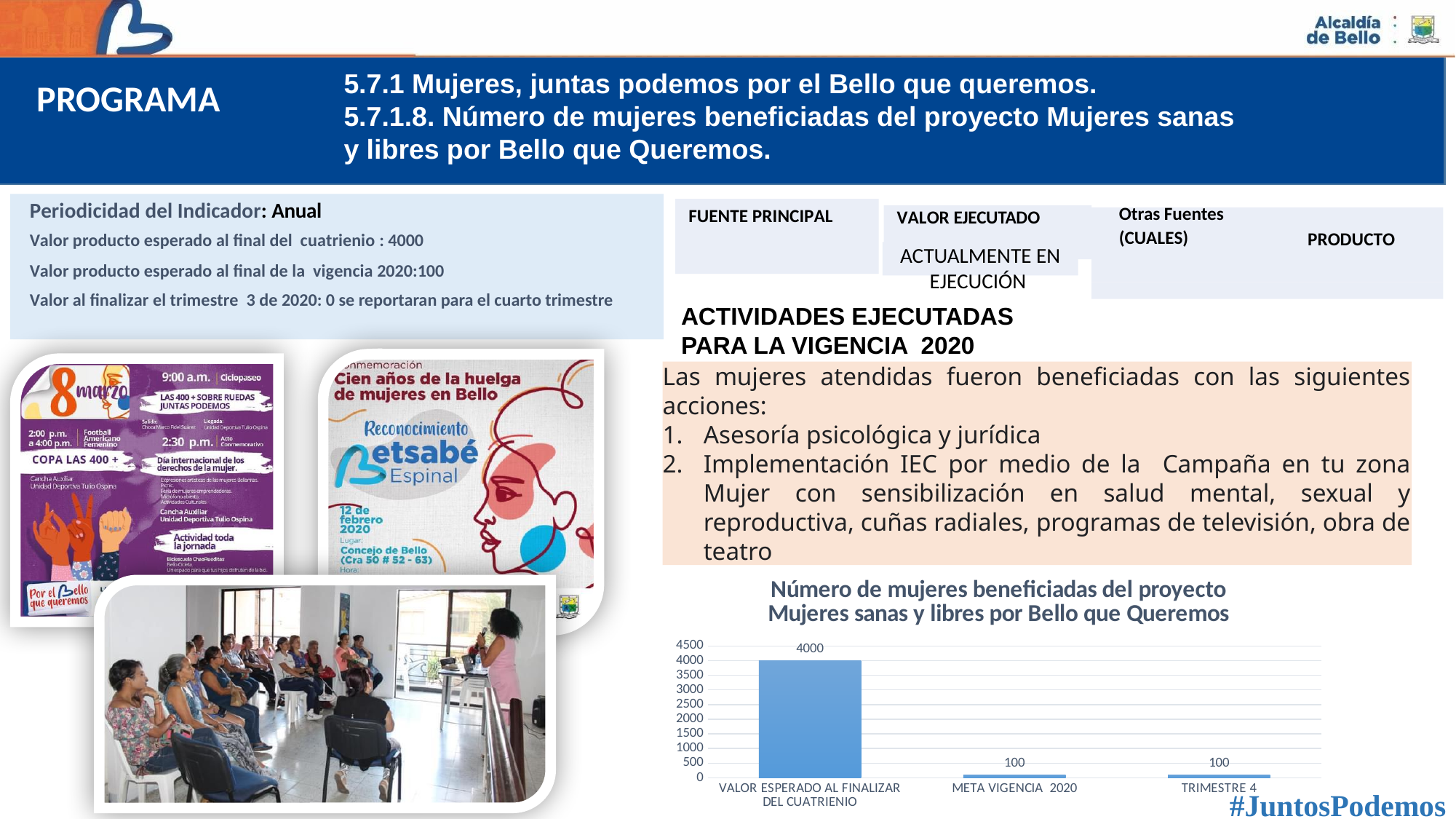
What is the title of the chart? Número de mujeres beneficiadas del proyecto Mujeres sanas y libres por Bello que Queremos Is the value for VALOR ESPERADO AL FINALIZAR DEL CUATRIENIO greater or less than 3500? greater How many categories are shown in the chart? 3 What is the value for TRIMESTRE 4 in the chart? 100 What is the difference between the value for VALOR ESPERADO AL FINALIZAR DEL CUATRIENIO and the value for META VIGENCIA 2020? 3900 What is the value for META VIGENCIA 2020 in the chart? 100 Which category has the highest value in the chart? VALOR ESPERADO AL FINALIZAR DEL CUATRIENIO Which is larger, the value for VALOR ESPERADO AL FINALIZAR DEL CUATRIENIO or the value for TRIMESTRE 4? VALOR ESPERADO AL FINALIZAR DEL CUATRIENIO What kind of chart is shown on the slide? bar chart What is the highest value shown on the vertical axis of the chart? 4500 What is the value for VALOR ESPERADO AL FINALIZAR DEL CUATRIENIO in the chart? 4000 Is the value for META VIGENCIA 2020 greater or less than 500? less